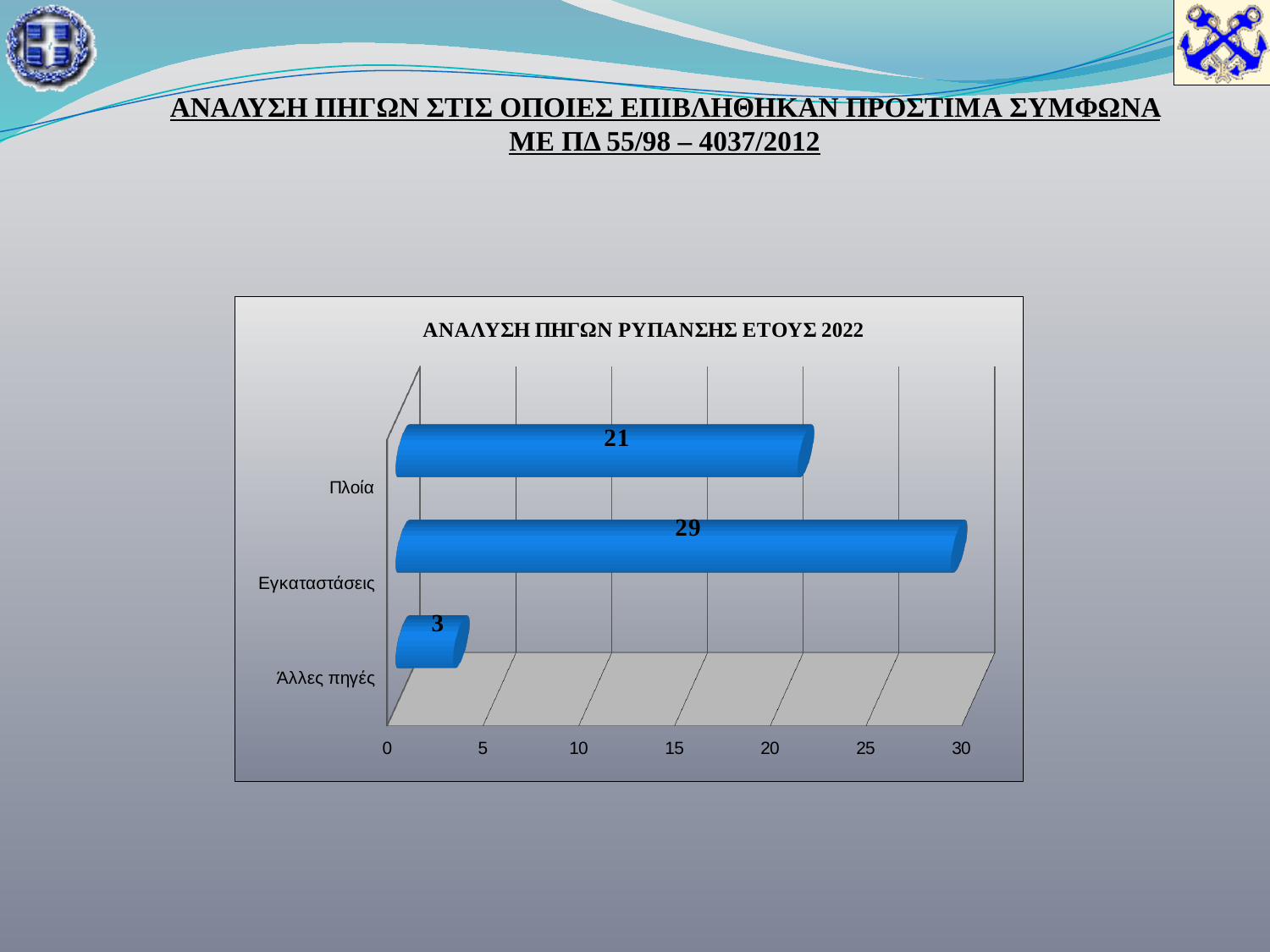
What is the value for Άλλες πηγές? 3 What is the difference between the values for Εγκαταστάσεις and Πλοία? 8 What is the difference between the values for Πλοία and Άλλες πηγές? 18 Which category has the lowest value? Άλλες πηγές How many categories are shown in the chart? 3 Which category has the highest value? Εγκαταστάσεις What kind of chart is shown on the slide? bar chart Which is larger, the value for Πλοία or the value for Εγκαταστάσεις? Εγκαταστάσεις Is the value for Πλοία greater or less than 20? greater What is the value for Πλοία? 21 What is the value for Εγκαταστάσεις? 29 What is the title of the chart? ΑΝΑΛΥΣΗ ΠΗΓΩΝ ΡΥΠΑΝΣΗΣ ΕΤΟΥΣ 2022